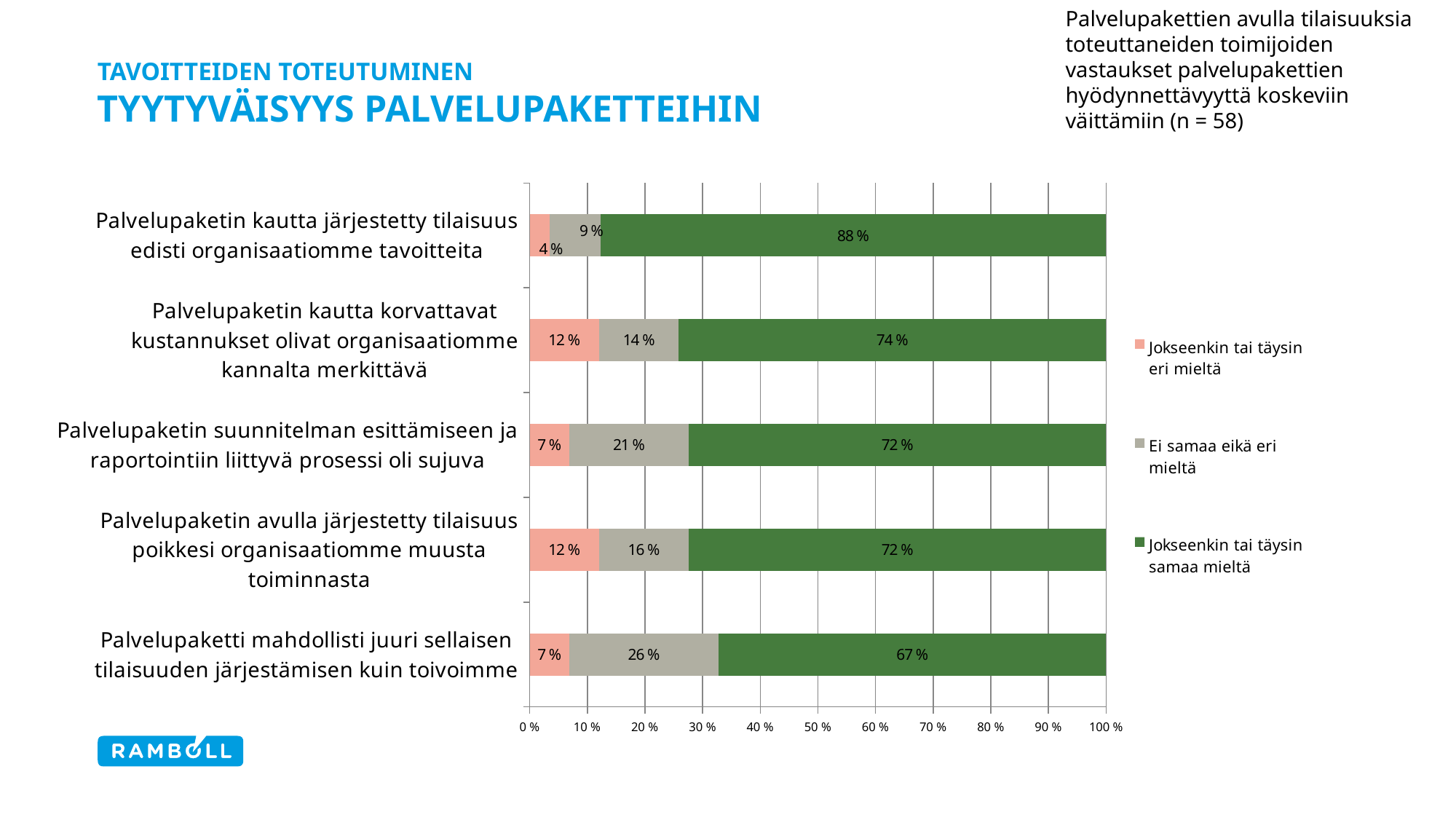
Which is larger: the 'Ei samaa eikä eri mieltä' share for 'Palvelupaketin suunnitelman esittämiseen ja raportointiin liittyvä prosessi oli sujuva' or for 'Palvelupaketin avulla järjestetty tilaisuus poikkesi organisaatiomme muusta toiminnasta'? Palvelupaketin suunnitelman esittämiseen ja raportointiin liittyvä prosessi oli sujuva (21 %) Which statement has the lowest 'Jokseenkin tai täysin samaa mieltä' share? Palvelupaketti mahdollisti juuri sellaisen tilaisuuden järjestämisen kuin toivoimme What kind of chart is shown on the slide? Stacked bar chart Is the 'Jokseenkin tai täysin samaa mieltä' share for 'Palvelupaketin kautta korvattavat kustannukset olivat organisaatiomme kannalta merkittävä' greater or less than 70 %? greater What percentage of respondents were 'Jokseenkin tai täysin samaa mieltä' with the statement 'Palvelupaketin kautta järjestetty tilaisuus edisti organisaatiomme tavoitteita'? 88 % What is the 'Jokseenkin tai täysin eri mieltä' share for 'Palvelupaketin kautta korvattavat kustannukset olivat organisaatiomme kannalta merkittävä'? 12 % Which statement has the highest 'Jokseenkin tai täysin samaa mieltä' share? Palvelupaketin kautta järjestetty tilaisuus edisti organisaatiomme tavoitteita How many statements (categories) are shown in the chart? 5 How many series does the legend list? 3 Which colour represents 'Jokseenkin tai täysin samaa mieltä' in the chart? Green What is the difference between the highest and lowest 'Jokseenkin tai täysin samaa mieltä' shares (88 % and 67 %)? 21 % What is the 'Ei samaa eikä eri mieltä' share for 'Palvelupaketti mahdollisti juuri sellaisen tilaisuuden järjestämisen kuin toivoimme'? 26 %